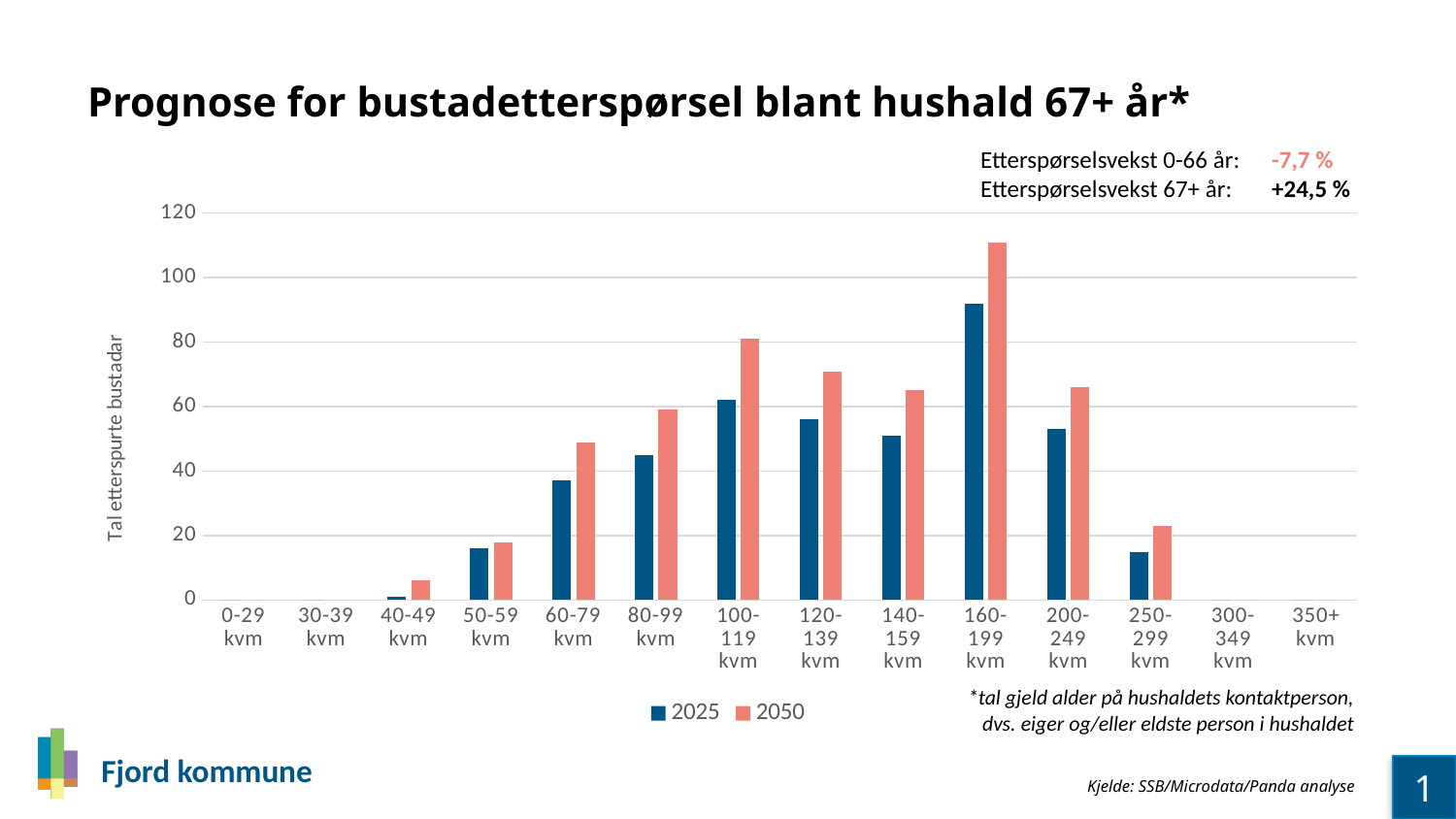
Which size category has the highest value for the 2050 series? 160-199 kvm Which size category has the highest value for the 2025 series? 160-199 kvm Is the 2050 value for 160-199 kvm greater or less than 100? greater Is the 2025 value for 50-59 kvm greater or less than 20? less Which two series are listed in the legend? 2025 and 2050 For 160-199 kvm, which series has the larger value, 2025 or 2050? 2050 How many size categories (kvm groups) are shown on the x axis? 14 Is the 2025 value for 160-199 kvm greater or less than 80? greater What kind of chart is shown on the slide? Bar chart How many series does the legend list? 2 What is the label on the vertical axis? Tal etterspurte bustadar